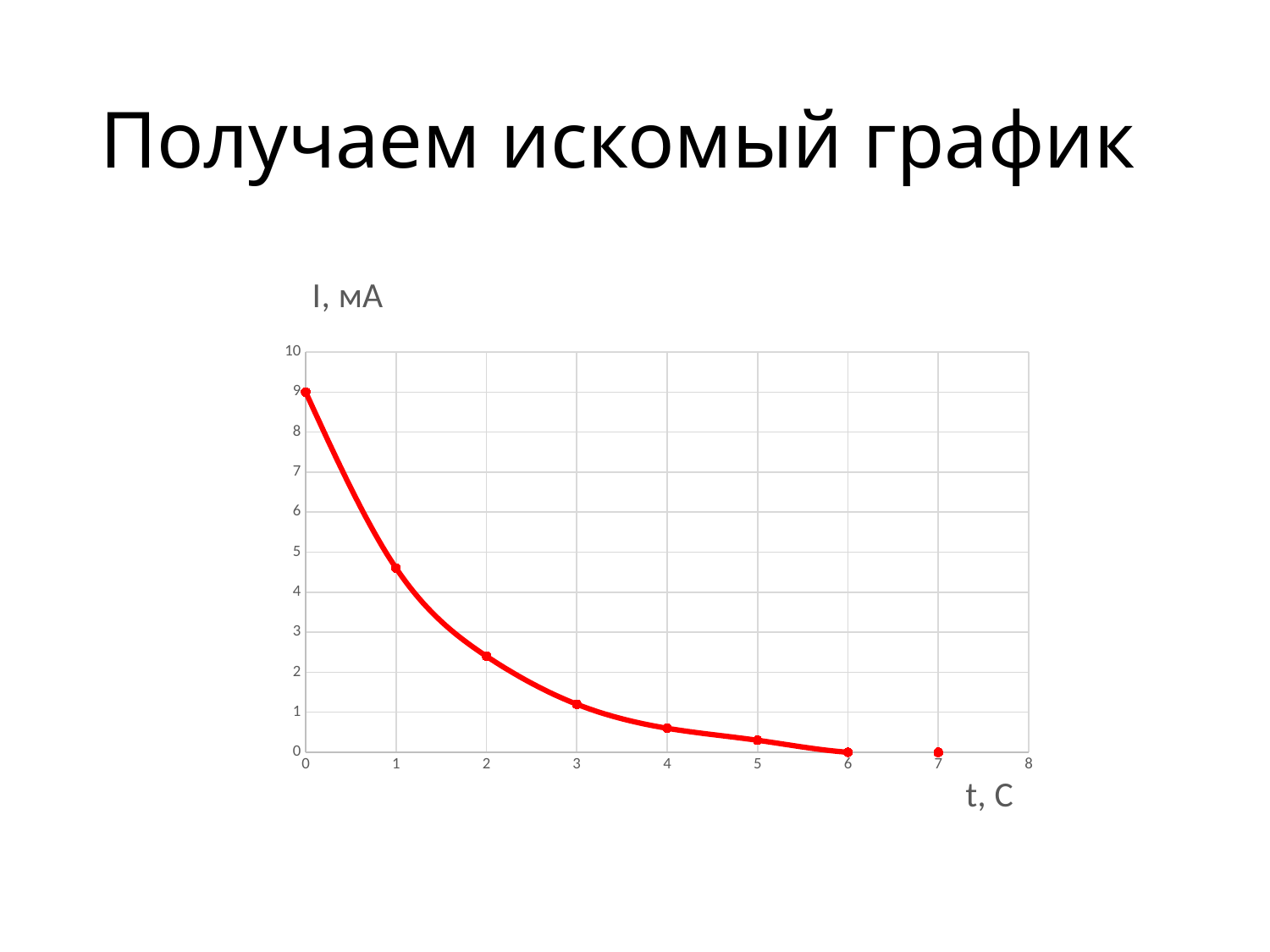
How many data points are plotted on the chart? 8 What kind of chart is shown on the slide? line chart Is the value of I at t = 0 greater or less than 8? greater Which is larger, the value of I at t = 1 or at t = 3? t = 1 At which value of t is the current I highest? 0 What is the value of I at t = 6? 0 What is the value of I at t = 7? 0 Is the value of I at t = 4 greater or less than 1? less Do the values rise or fall as t increases along the x axis? fall Is the value of I at t = 1 greater or less than 4? greater What is the label of the vertical axis of the chart? I, мА